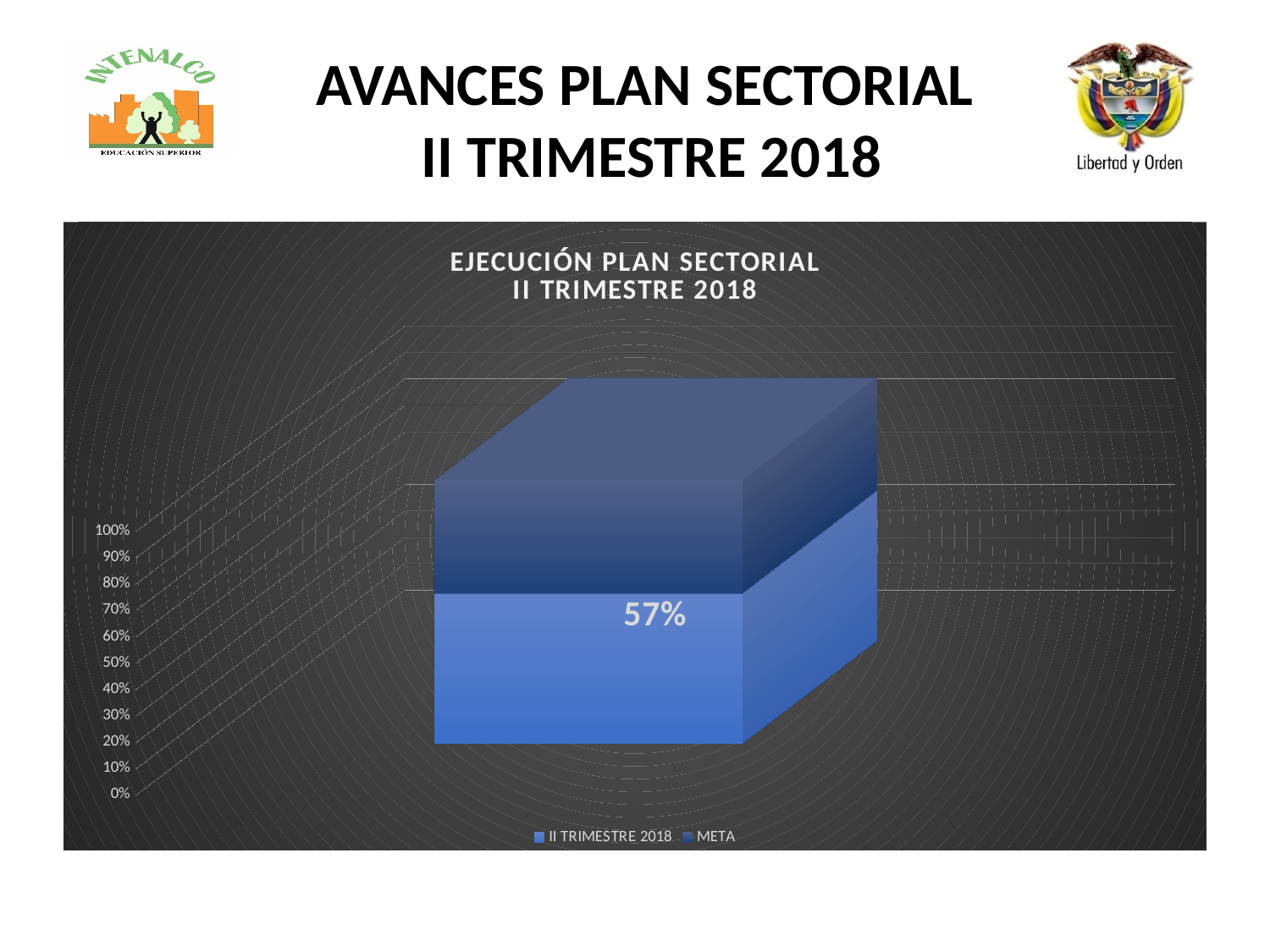
What are the two entries in the chart legend? II TRIMESTRE 2018 and META Is the value for II TRIMESTRE 2018 greater or less than 70%? less What value is labelled on the II TRIMESTRE 2018 segment of the bar? 57% Is the value for II TRIMESTRE 2018 greater or less than 60%? less How many stacked bars are plotted in the chart? 1 What is the title of the chart? EJECUCIÓN PLAN SECTORIAL II TRIMESTRE 2018 Is the value for II TRIMESTRE 2018 greater or less than 50%? greater What kind of chart is shown on the slide? bar chart What is the highest value shown on the vertical axis of the chart? 100% How many series does the chart legend list? 2